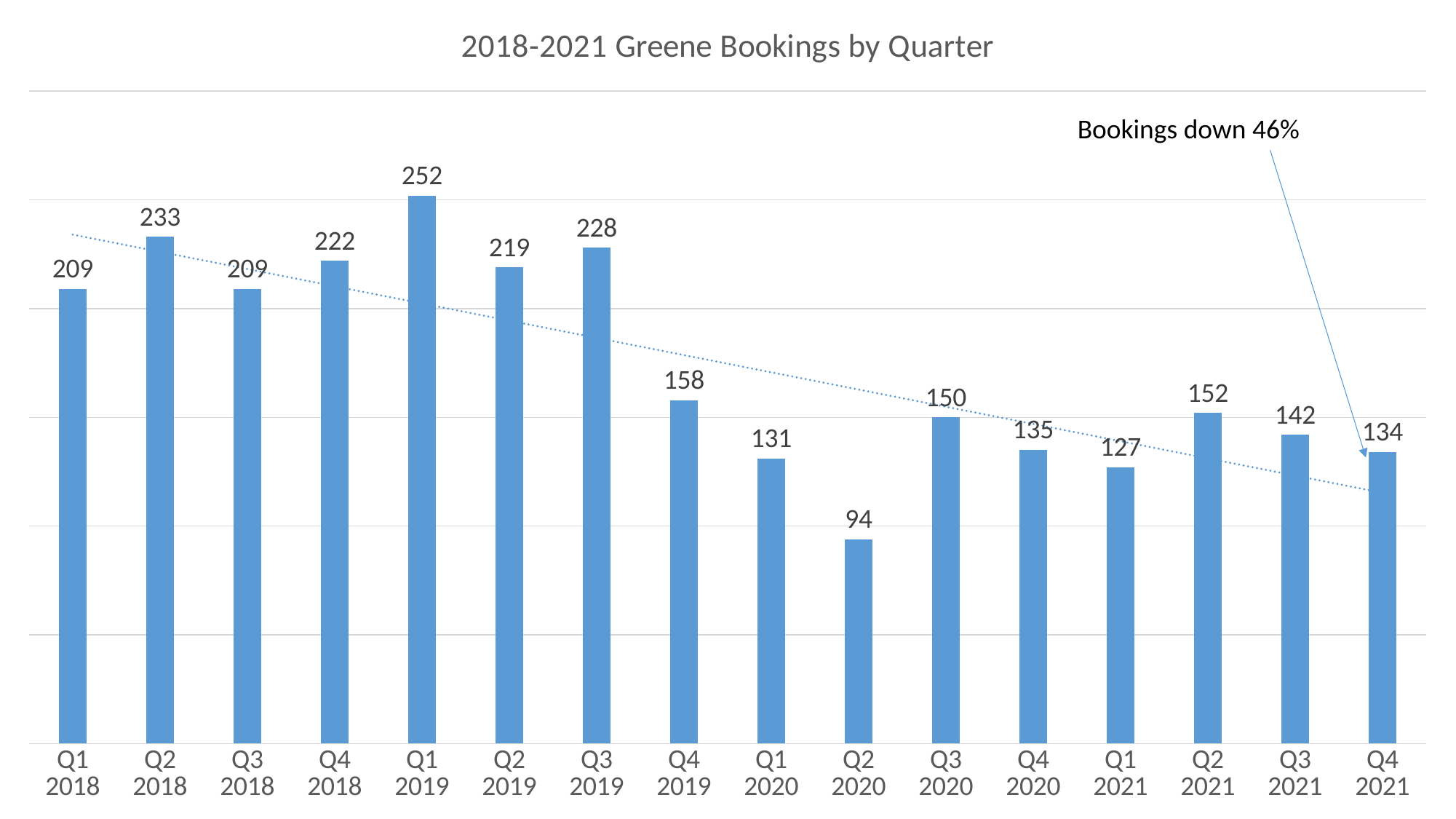
What is the difference between Q2 2018 and Q4 2018? 11 What is the value for Q2 2020? 94 What is the value for Q1 2019? 252 What is the title of the chart? 2018-2021 Greene Bookings by Quarter Which quarter has the lowest bookings? Q2 2020 Which is larger, Q3 2019 or Q4 2019? Q3 2019 Do the bookings generally rise or fall from Q1 2018 to Q4 2021? Fall How many quarters are shown on the chart? 16 What is the value for Q4 2021? 134 What kind of chart is this? Bar chart Which quarter has the highest bookings? Q1 2019 What is the difference between Q1 2019 and Q2 2020? 158